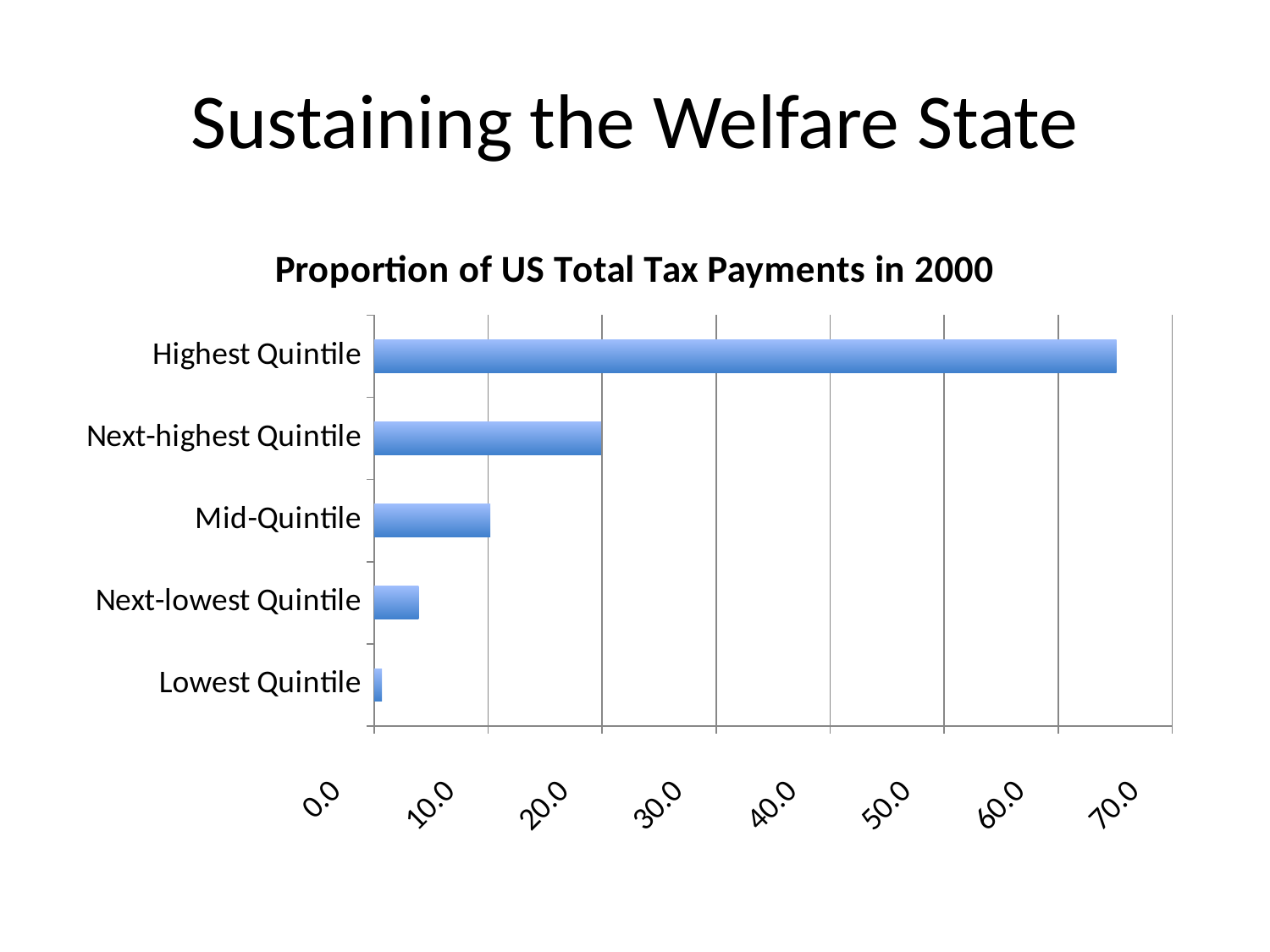
Is the value for the Next-lowest Quintile greater or less than 10.0? less Which quintile has the highest proportion of US total tax payments? Highest Quintile Which has a larger proportion of tax payments, the Next-highest Quintile or the Mid-Quintile? Next-highest Quintile What is the title of the chart? Proportion of US Total Tax Payments in 2000 What is the highest value shown on the horizontal axis? 70.0 Is the value for the Lowest Quintile greater or less than 10.0? less Is the value for the Highest Quintile greater or less than 70.0? less Which quintile has the lowest proportion of US total tax payments? Lowest Quintile Which has a larger proportion of tax payments, the Mid-Quintile or the Next-lowest Quintile? Mid-Quintile What kind of chart is shown on the slide? bar chart How many quintile categories are plotted in the chart? 5